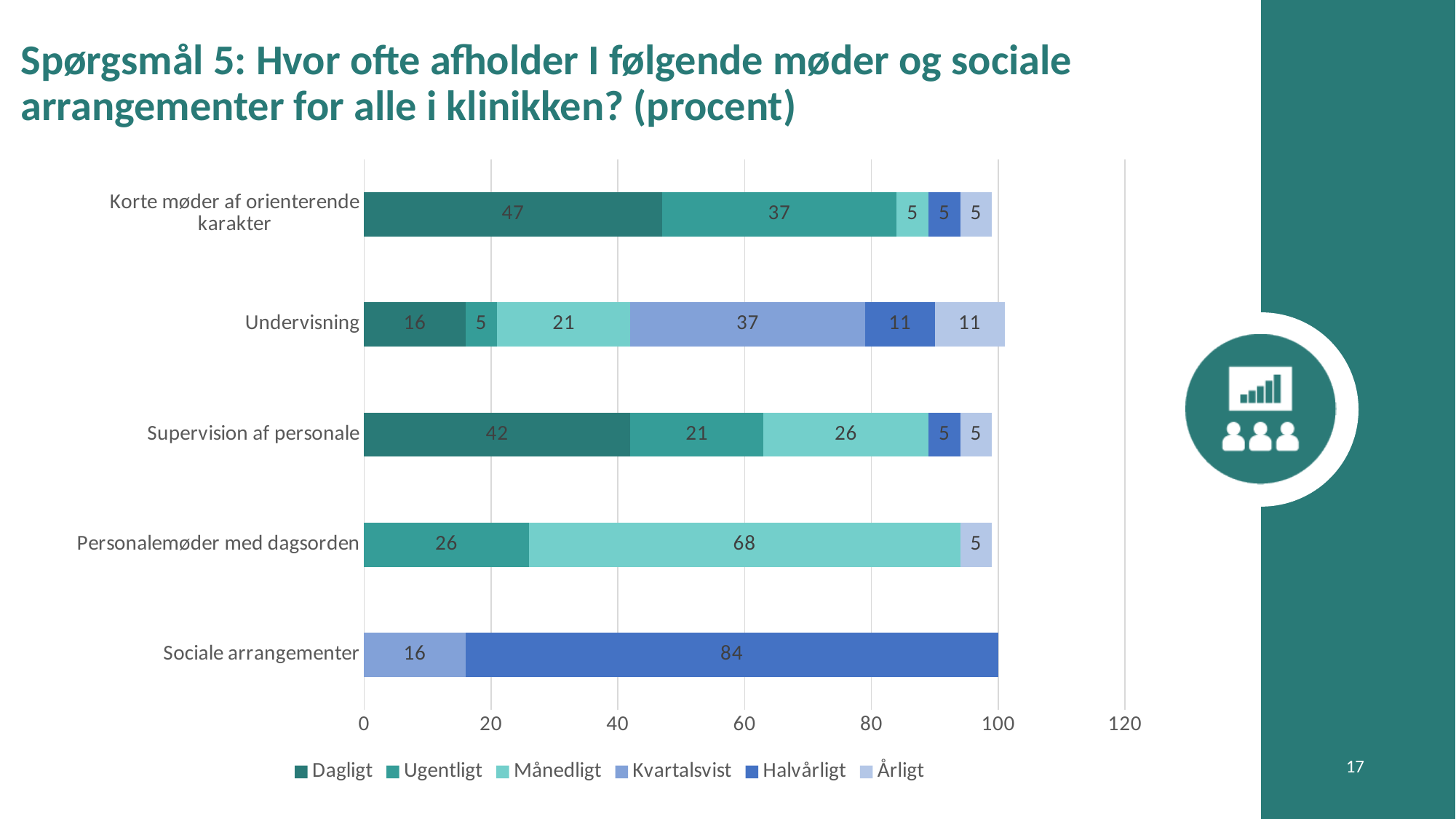
What is the Kvartalsvist value for Undervisning? 37 How many categories are shown on the vertical axis? 5 Which category has the highest Dagligt value? Korte møder af orienterende karakter Which legend entry is shown in the darkest blue colour? Halvårligt Which is larger: the Ugentligt value for Personalemøder med dagsorden or the Ugentligt value for Supervision af personale? Personalemøder med dagsorden What is the Dagligt value for Korte møder af orienterende karakter? 47 What is the total of the stacked bar for Undervisning? 101 What kind of chart is shown on the slide? Stacked bar chart What is the Månedligt value for Personalemøder med dagsorden? 68 How many series does the legend list? 6 What is the difference between the Dagligt value for Supervision af personale and the Dagligt value for Undervisning? 26 What is the Halvårligt value for Sociale arrangementer? 84